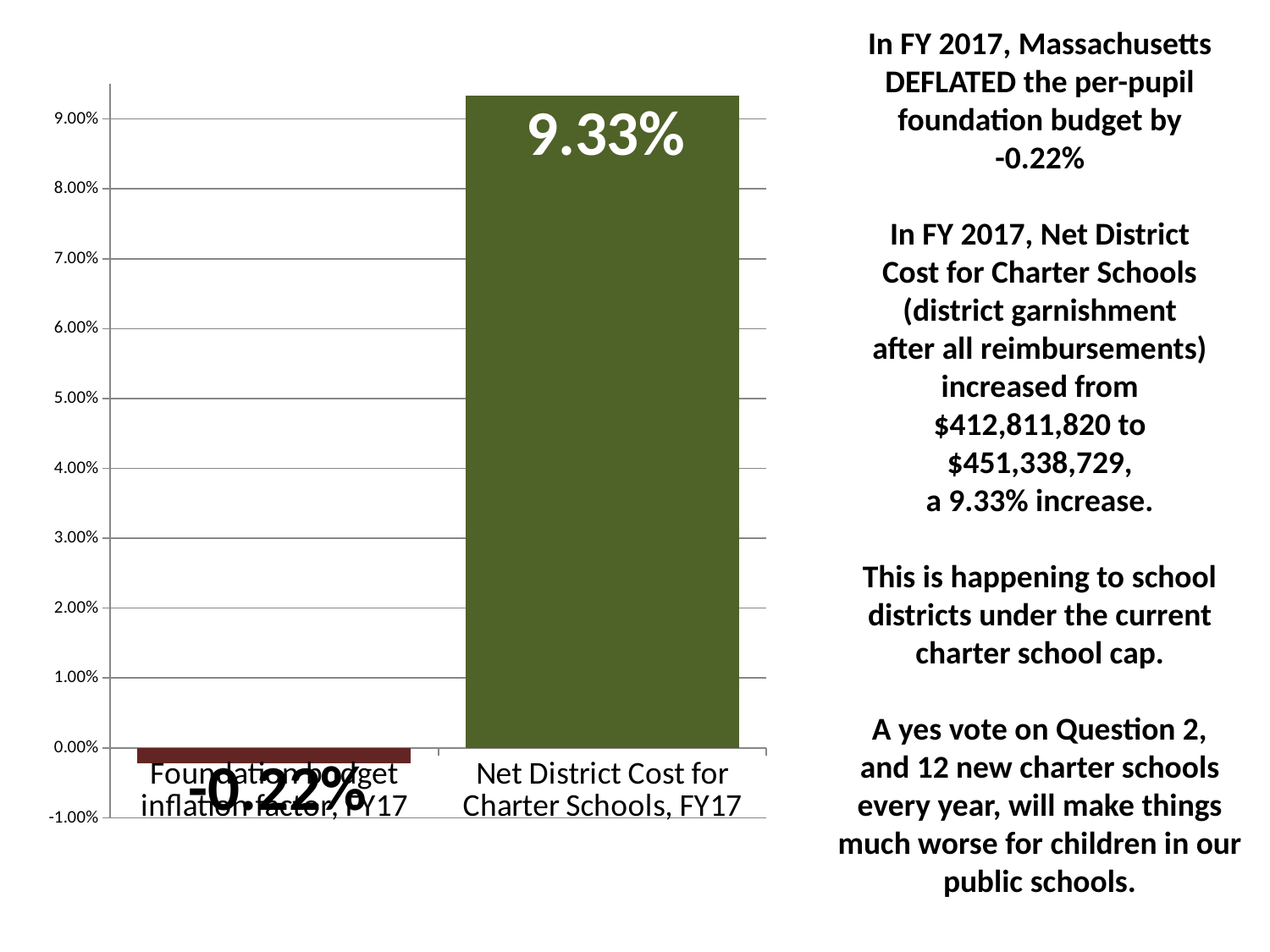
Is the value for Foundation budget inflation factor, FY17 greater or less than 0.00%? less What colour is the bar for Net District Cost for Charter Schools, FY17? Green What is the highest value labelled on the vertical axis? 9.00% What kind of chart is shown on the slide? Bar chart What is the difference between the value for Net District Cost for Charter Schools, FY17 and the value for Foundation budget inflation factor, FY17? 9.55% Is the value for Net District Cost for Charter Schools, FY17 greater or less than 8.00%? greater Which is larger: the value for Foundation budget inflation factor, FY17 or the value for Net District Cost for Charter Schools, FY17? Net District Cost for Charter Schools, FY17 Which category has the highest value? Net District Cost for Charter Schools, FY17 What is the value for Net District Cost for Charter Schools, FY17? 9.33% Which category has the lowest value? Foundation budget inflation factor, FY17 How many categories are shown in the chart? 2 What is the value for Foundation budget inflation factor, FY17? -0.22%